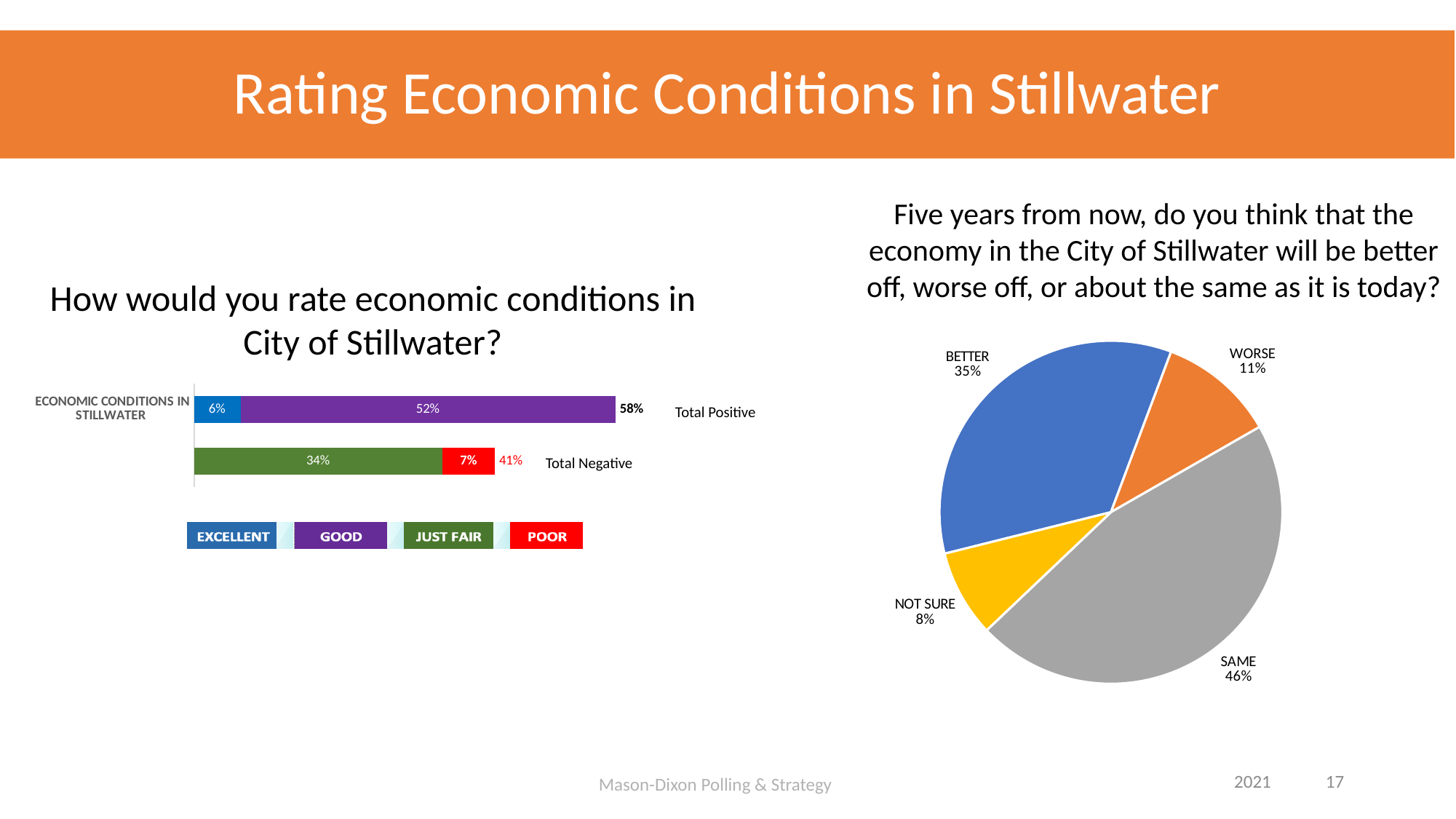
In the bar chart on the left, what percentage rated economic conditions in Stillwater as Good? 52% In the bar chart on the left, what is the difference between the Just Fair and Poor percentages? 27% In the pie chart on the right, which response has the smallest share? Not Sure In the bar chart on the left, what is the Total Negative percentage? 41% What type of chart is shown on the right side of the slide? Pie chart In the bar chart on the left, how many rating categories does the legend list? 4 In the bar chart on the left, what percentage rated economic conditions in Stillwater as Poor? 7% In the bar chart on the left, what percentage rated economic conditions in Stillwater as Excellent? 6% In the bar chart on the left, which rating category has the highest percentage? Good In the bar chart on the left, what is the Total Positive percentage? 58% In the pie chart on the right, what share of respondents said the economy will be the Same? 46% In the pie chart on the right, what is the difference between the Better and Worse shares? 24%